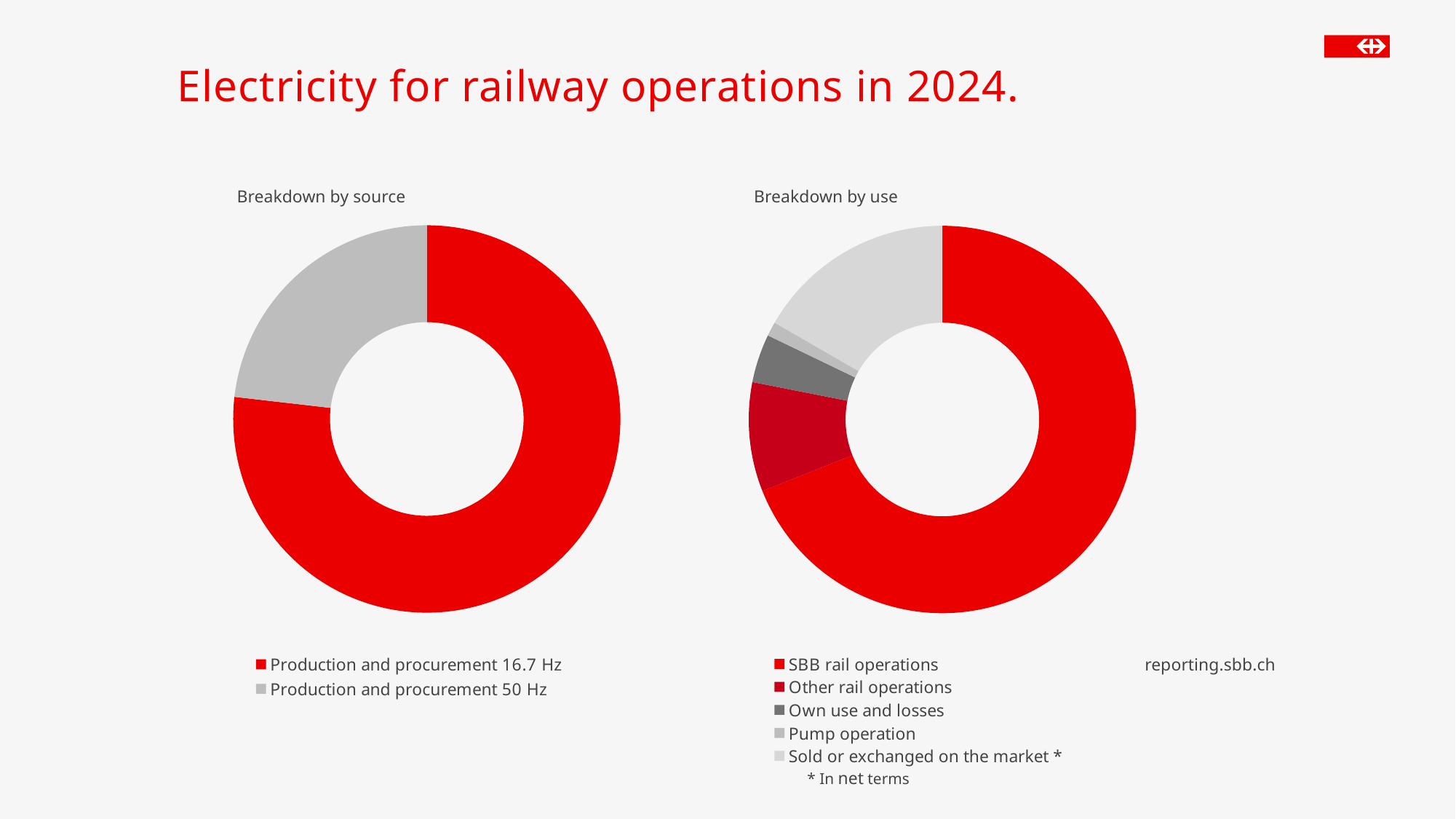
In the 'Breakdown by use' chart, which is larger: 'Own use and losses' or 'Pump operation'? Own use and losses How many slices does the 'Breakdown by source' chart have? 2 In the 'Breakdown by use' chart, which category has the largest share? SBB rail operations In the 'Breakdown by source' chart, which category has the largest share? Production and procurement 16.7 Hz How many slices does the 'Breakdown by use' chart have? 5 What kind of chart is the 'Breakdown by use' chart? Pie chart (donut) In the 'Breakdown by use' chart, which category has the smallest share? Pump operation What kind of chart is the 'Breakdown by source' chart? Pie chart (donut) In the 'Breakdown by source' chart, which category has the smallest share? Production and procurement 50 Hz In the 'Breakdown by use' chart, which is larger: 'Sold or exchanged on the market' or 'Other rail operations'? Sold or exchanged on the market How many entries does the legend of the 'Breakdown by use' chart list? 5 What is the title of the slide? Electricity for railway operations in 2024.